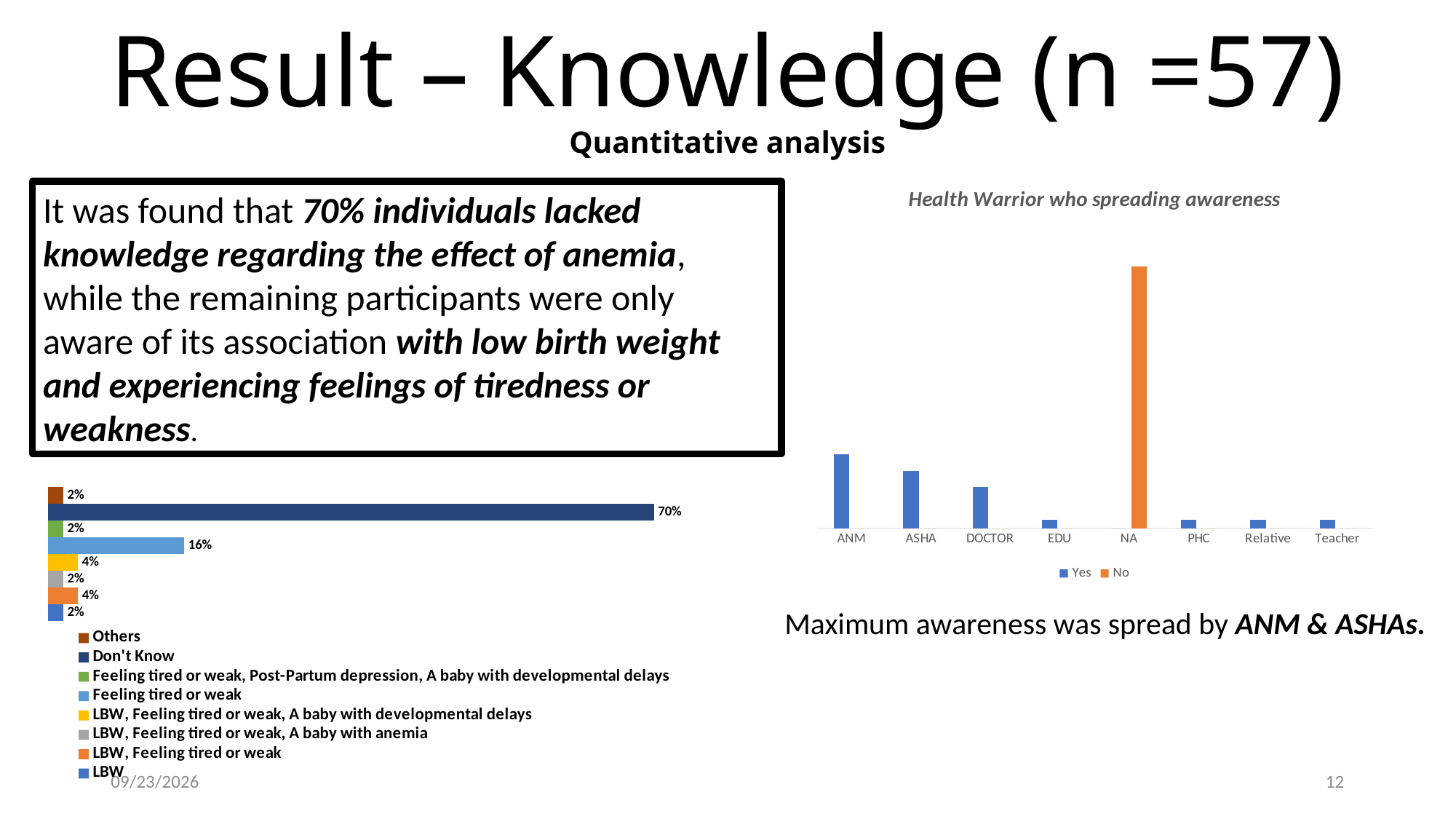
How many categories are shown on the x axis of the chart titled "Health Warrior who spreading awareness"? 8 In the chart on the left of the slide, what is the value for "LBW, Feeling tired or weak"? 4% In the chart on the left of the slide, which category has the highest value? Don't Know In the chart on the left of the slide, what is the value for "Feeling tired or weak"? 16% How many categories does the legend of the chart on the left of the slide list? 8 In the chart on the left of the slide, what is the value for "Don't Know"? 70% In the chart on the left of the slide, which is larger: the value for "Feeling tired or weak" or the value for "LBW, Feeling tired or weak"? Feeling tired or weak How many series does the legend of the chart titled "Health Warrior who spreading awareness" list? 2 In the chart titled "Health Warrior who spreading awareness", which category has the tallest bar? NA What kind of chart is the chart on the left of the slide? Bar chart In the chart titled "Health Warrior who spreading awareness", which is larger: the Yes bar for ANM or the Yes bar for ASHA? ANM In the chart on the left of the slide, what is the difference between the values for "Don't Know" and "Feeling tired or weak"? 54%